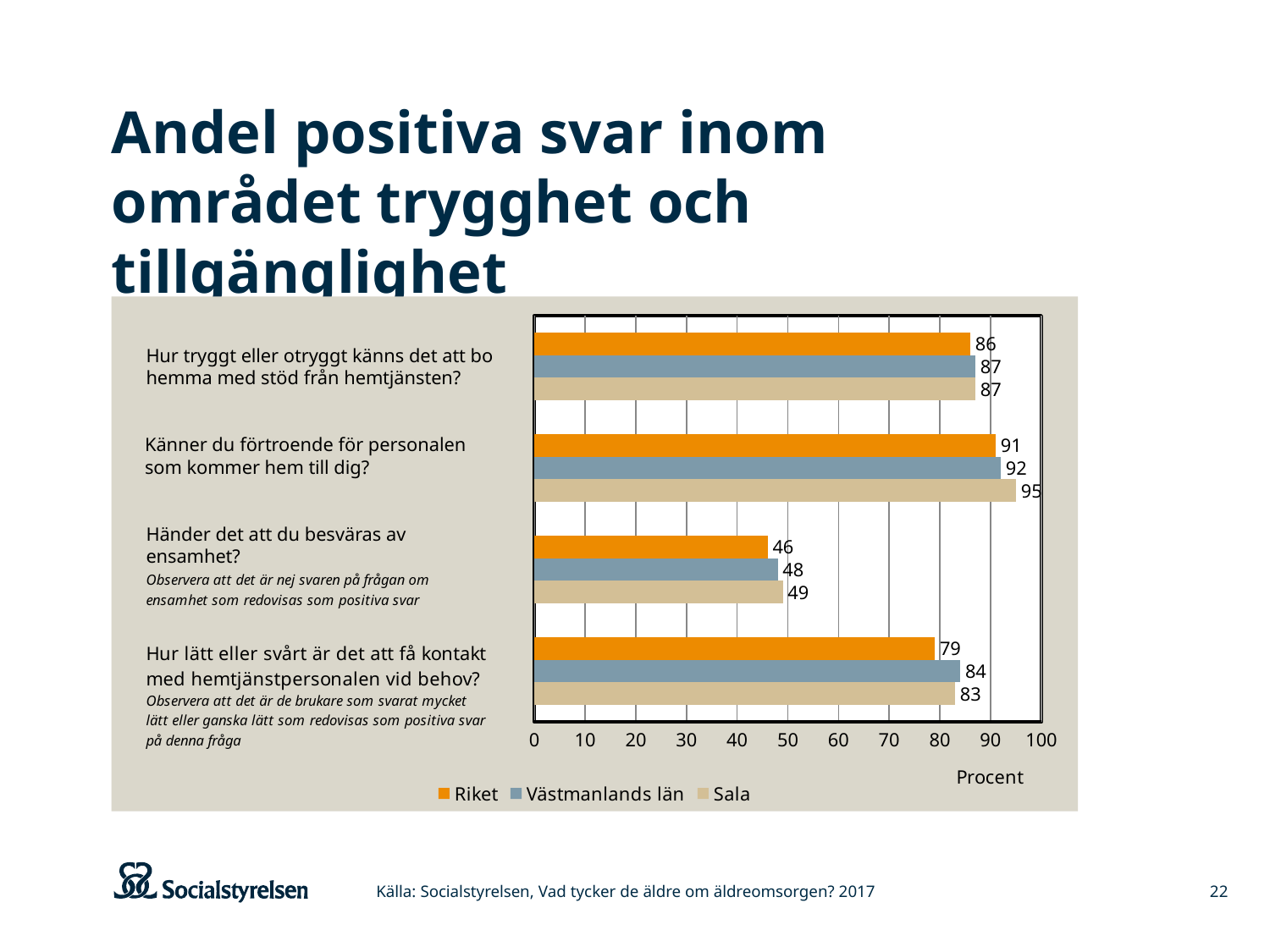
Which is larger on the question 'Hur lätt eller svårt är det att få kontakt med hemtjänstpersonalen vid behov?': Västmanlands län or Sala? Västmanlands län Which question has the lowest value for Riket? Händer det att du besväras av ensamhet? How many question categories are plotted in the chart? 4 What is the difference between Västmanlands län and Riket on the question 'Hur lätt eller svårt är det att få kontakt med hemtjänstpersonalen vid behov?' 5 What unit is shown on the horizontal axis of the chart? Procent How many series does the legend list? 3 On the question 'Händer det att du besväras av ensamhet?', is the value for Sala greater or less than 50? less What is the value for Västmanlands län on the question 'Händer det att du besväras av ensamhet?' 48 What type of chart is shown on the slide? Bar chart What is the value for Sala on the question 'Känner du förtroende för personalen som kommer hem till dig?' 95 What is the value for Riket on the question 'Hur lätt eller svårt är det att få kontakt med hemtjänstpersonalen vid behov?' 79 Which series has the highest value on the question 'Känner du förtroende för personalen som kommer hem till dig?' Sala